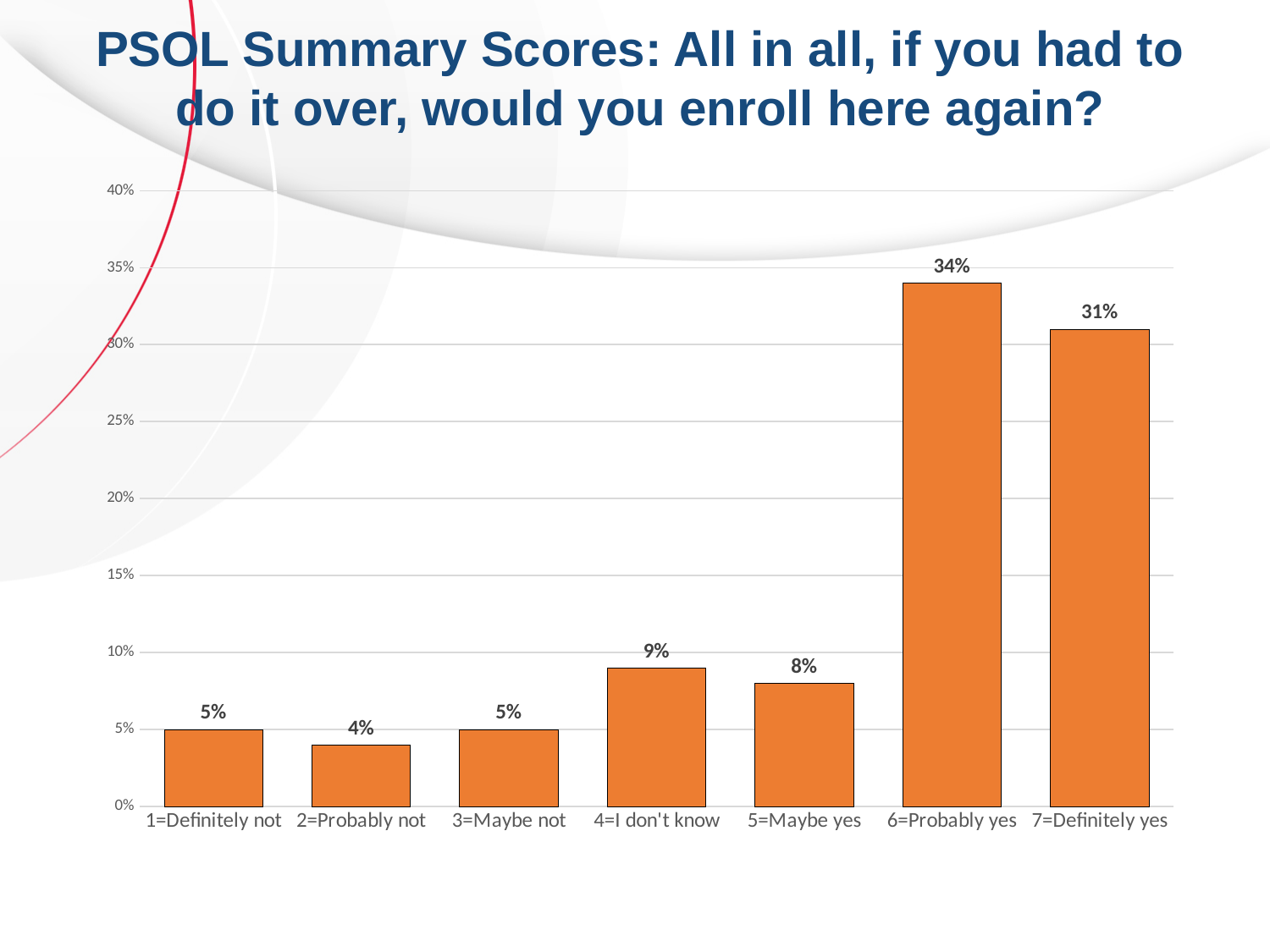
How many categories are shown on the x axis? 7 What kind of chart is shown on the slide? bar chart What is the value for 2=Probably not? 4% Which category has the highest value? 6=Probably yes What is the highest value shown on the y axis? 40% What is the value for 6=Probably yes? 34% Which category has the lowest value? 2=Probably not Is the value for 7=Definitely yes greater or less than 30%? greater What is the value for 4=I don't know? 9% Which is larger, the value for 5=Maybe yes or the value for 4=I don't know? 4=I don't know What is the difference between the values for 6=Probably yes and 7=Definitely yes? 3% What is the total of the values for 1=Definitely not, 2=Probably not and 3=Maybe not? 14%